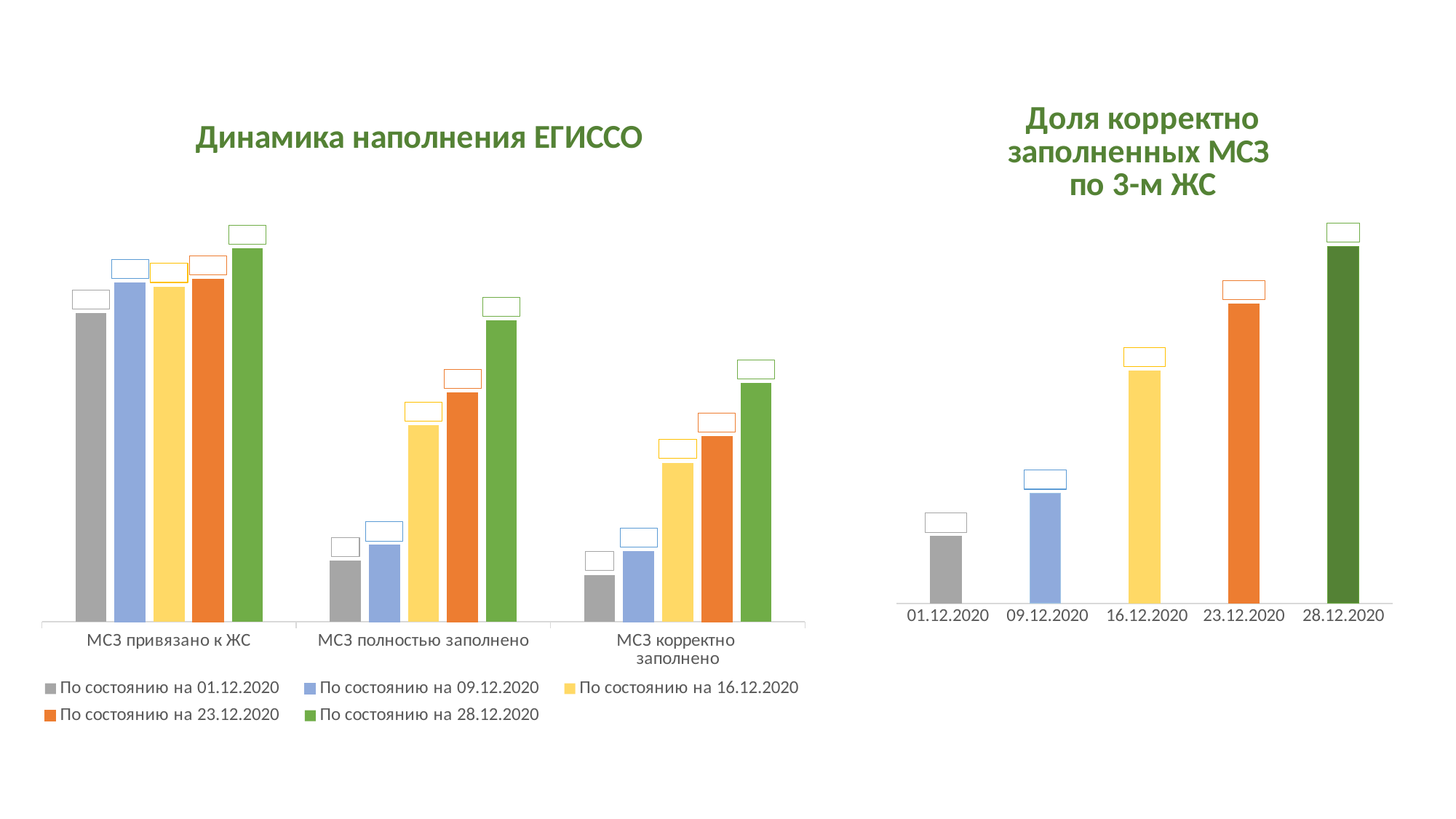
In the chart titled "Динамика наполнения ЕГИССО", which series has the lowest value for "МСЗ корректно заполнено"? По состоянию на 01.12.2020 How many dates are shown on the x axis of the chart titled "Доля корректно заполненных МСЗ по 3-м ЖС"? 5 What kind of chart is the chart titled "Динамика наполнения ЕГИССО"? bar chart In the chart titled "Доля корректно заполненных МСЗ по 3-м ЖС", which date has the lowest value? 01.12.2020 In the chart titled "Динамика наполнения ЕГИССО", which series has the highest value for "МСЗ полностью заполнено"? По состоянию на 28.12.2020 In the chart titled "Доля корректно заполненных МСЗ по 3-м ЖС", which date has the highest value? 28.12.2020 In the chart titled "Доля корректно заполненных МСЗ по 3-м ЖС", do the values rise or fall from 01.12.2020 to 28.12.2020? rise In the chart titled "Динамика наполнения ЕГИССО", which category has the larger value for "По состоянию на 01.12.2020": "МСЗ привязано к ЖС" or "МСЗ полностью заполнено"? МСЗ привязано к ЖС How many series does the legend of the chart titled "Динамика наполнения ЕГИССО" list? 5 In the chart titled "Динамика наполнения ЕГИССО", which colour represents the series "По состоянию на 23.12.2020"? orange What kind of chart is the chart titled "Доля корректно заполненных МСЗ по 3-м ЖС"? bar chart How many categories are shown on the x axis of the chart titled "Динамика наполнения ЕГИССО"? 3